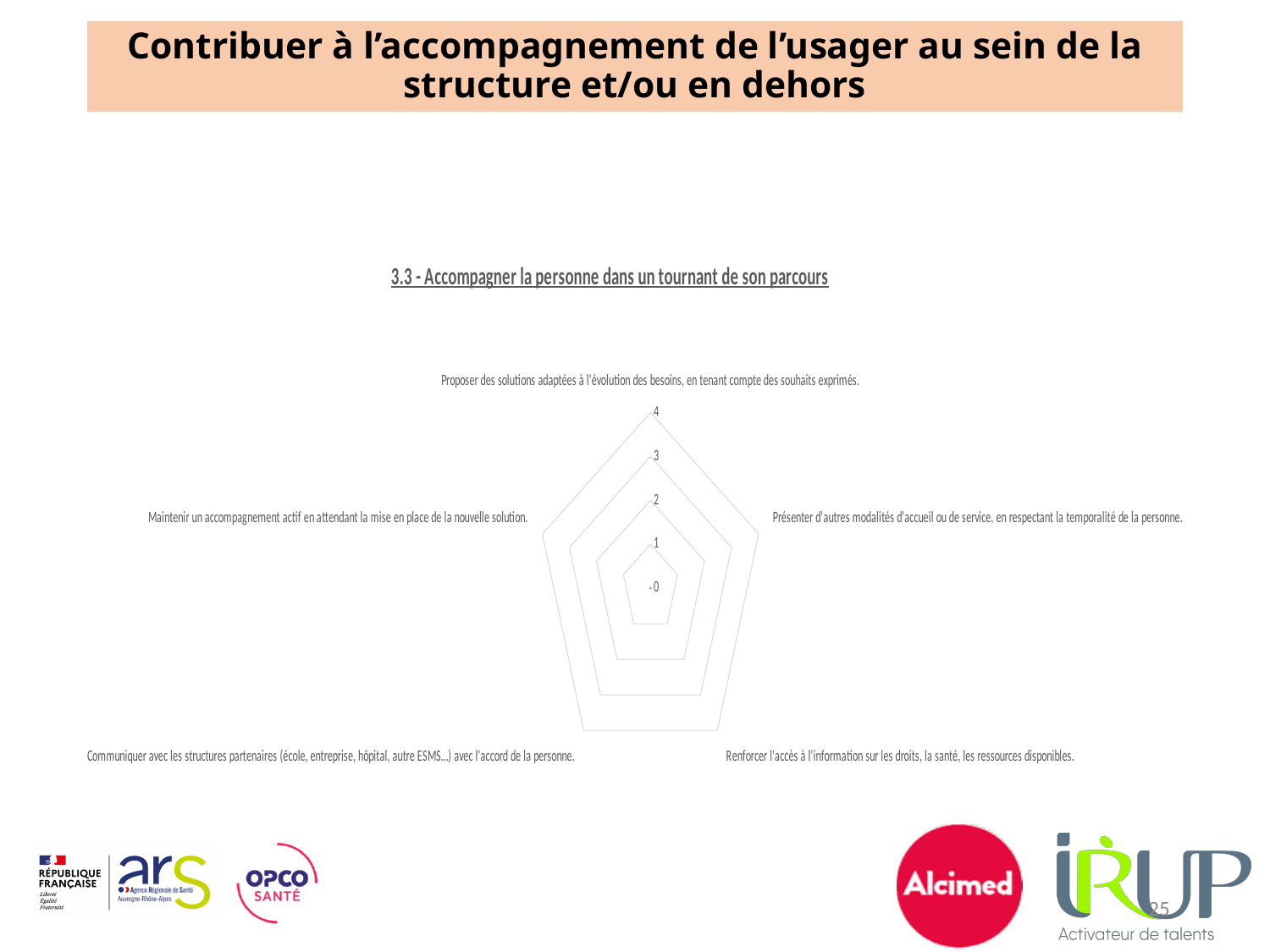
What kind of chart is shown on the slide? radar chart How many categories (axes) does the radar chart have? 5 Which category label appears at the bottom right of the radar chart? Renforcer l'accès à l'information sur les droits, la santé, les ressources disponibles. What is the highest tick value shown on the radar chart's axis? 4 Which category label appears at the bottom left of the radar chart? Communiquer avec les structures partenaires (école, entreprise, hôpital, autre ESMS...) avec l'accord de la personne. What is the title of the radar chart? 3.3 - Accompagner la personne dans un tournant de son parcours What is the lowest tick value shown on the radar chart's axis? 0 Which category label appears at the top of the radar chart? Proposer des solutions adaptées à l'évolution des besoins, en tenant compte des souhaits exprimés.